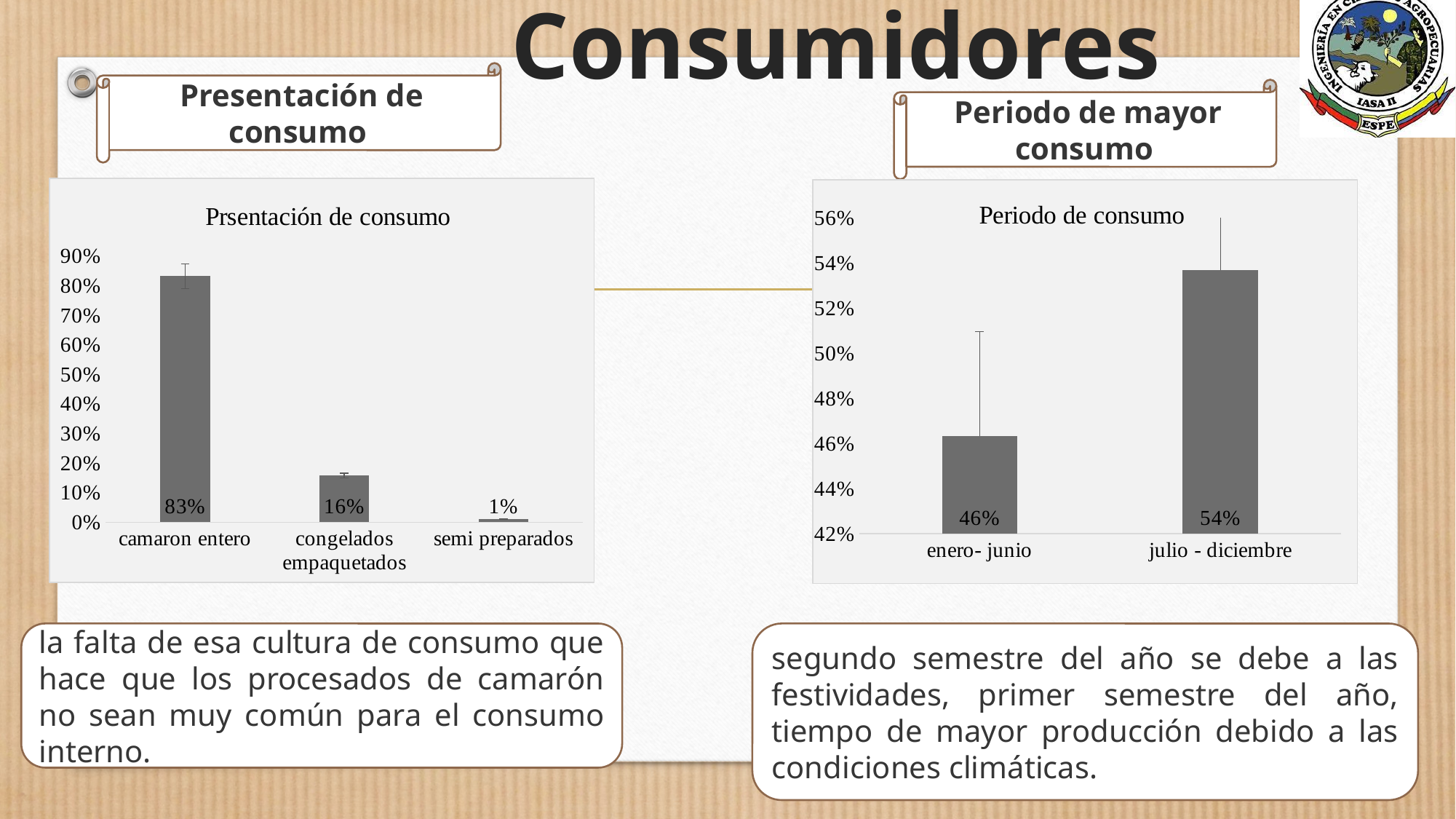
In the 'Periodo de consumo' chart, what is the value for enero- junio? 46% In the 'Prsentación de consumo' chart, what is the value for semi preparados? 1% What kind of chart is the 'Periodo de consumo' chart? bar chart In the 'Prsentación de consumo' chart, which category has the highest value? camaron entero In the 'Periodo de consumo' chart, what is the value for julio - diciembre? 54% In the 'Prsentación de consumo' chart, what is the value for camaron entero? 83% In the 'Prsentación de consumo' chart, which category has the lowest value? semi preparados In the 'Prsentación de consumo' chart, what is the value for congelados empaquetados? 16% In the 'Periodo de consumo' chart, which period has the larger value, enero- junio or julio - diciembre? julio - diciembre In the 'Periodo de consumo' chart, what is the difference between julio - diciembre and enero- junio? 8% In the 'Prsentación de consumo' chart, how many categories are shown? 3 In the 'Prsentación de consumo' chart, what is the difference between camaron entero and congelados empaquetados? 67%